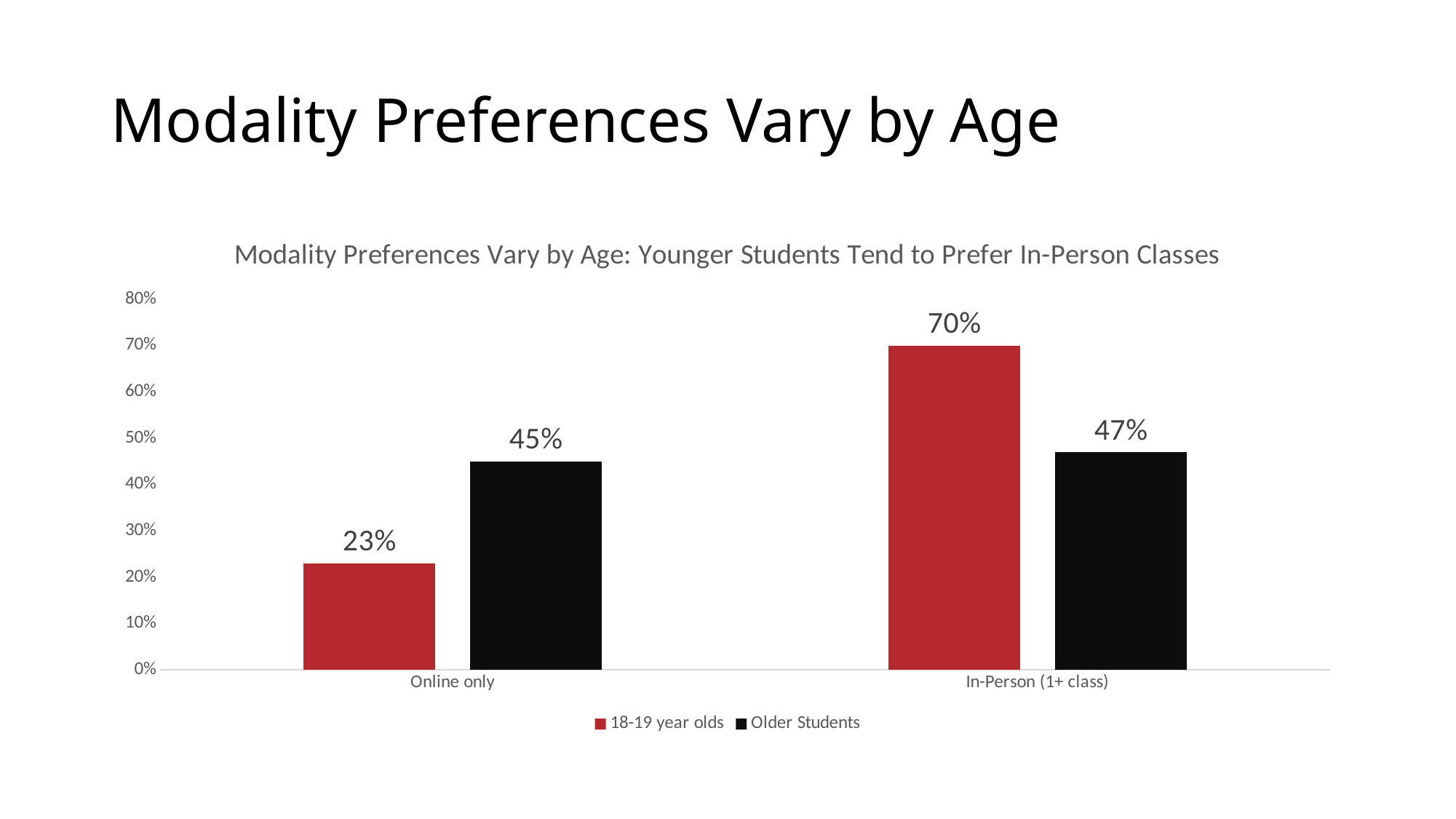
What is the value for Older Students in the Online only category? 45% What is the value for 18-19 year olds in the In-Person (1+ class) category? 70% What percentage of Older Students prefer In-Person (1+ class)? 47% What type of chart is shown on the slide? Bar chart How many series does the legend list? 2 What is the difference between the 18-19 year olds and Older Students values for In-Person (1+ class)? 23% Which category has the highest value for 18-19 year olds? In-Person (1+ class) Which is larger for Older Students: Online only or In-Person (1+ class)? In-Person (1+ class) What is the difference between Older Students and 18-19 year olds for Online only? 22% What percentage of 18-19 year olds prefer Online only? 23% Which series has the lowest value in the Online only category? 18-19 year olds How many categories are shown on the x axis? 2